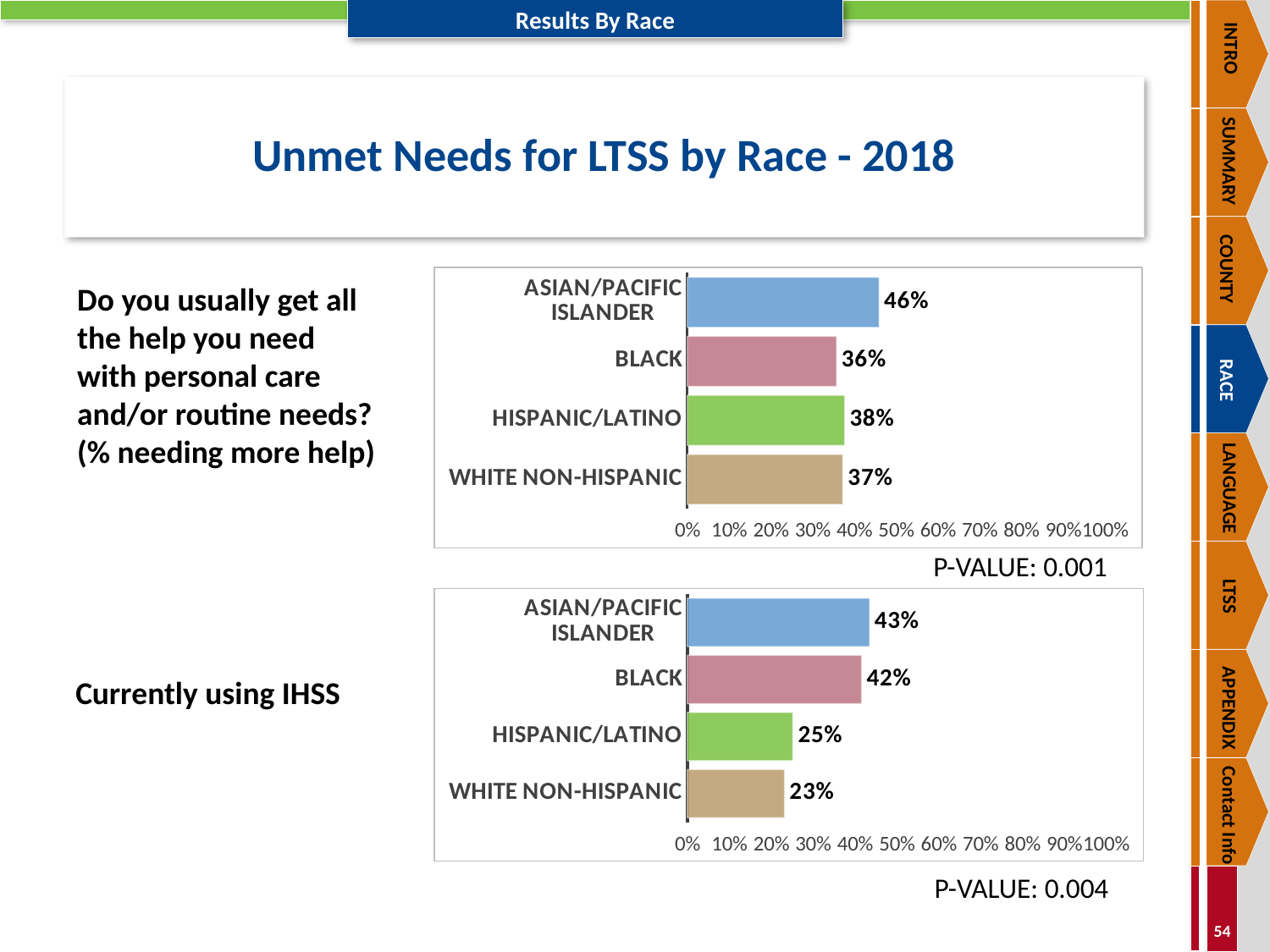
In the top chart (needing more help with personal care and/or routine needs), which race has the lowest value? Black In the bottom chart (Currently using IHSS), is the value for Asian/Pacific Islander greater or less than 50%? less What p-value is shown below the top chart? 0.001 In the top chart (needing more help with personal care and/or routine needs), which race has the highest value? Asian/Pacific Islander In the bottom chart (Currently using IHSS), which is larger, the value for Black or the value for Hispanic/Latino? Black What kind of chart is the bottom chart (Currently using IHSS)? Bar chart In the bottom chart (Currently using IHSS), what is the difference between Asian/Pacific Islander and White Non-Hispanic? 20% In the top chart (needing more help with personal care and/or routine needs), what is the difference between Asian/Pacific Islander and White Non-Hispanic? 9% How many race categories are shown in the top chart? 4 In the bottom chart (Currently using IHSS), what is the value for Hispanic/Latino? 25% In the bottom chart (Currently using IHSS), which race has the lowest value? White Non-Hispanic In the top chart (needing more help with personal care and/or routine needs), what is the value for Black? 36%